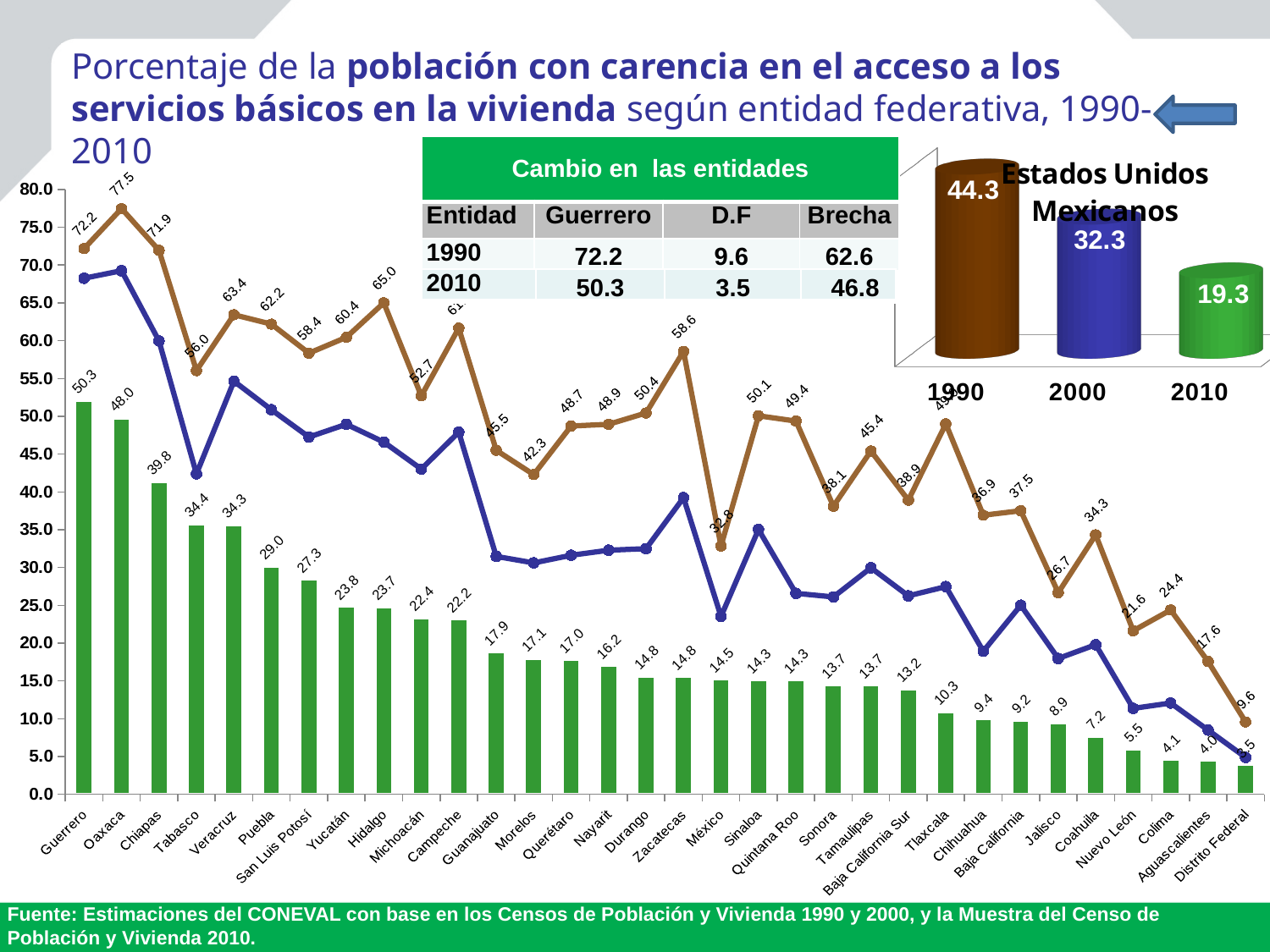
In the main chart, what is the 2010 bar value for Guerrero? 50.3 In the 'Estados Unidos Mexicanos' chart, do the values rise or fall from 1990 to 2010? fall In the main chart, what is the 2010 bar value for Distrito Federal? 3.5 In the main chart, is the 2000 line value for Guerrero greater or less than 65.0? greater How many entities are shown on the x axis of the main chart? 32 In the main chart, which entity has the lowest 2010 bar value? Distrito Federal In the main chart, what is the difference between the 2010 bar values of Guerrero and Oaxaca? 2.3 What kind of chart is the 'Estados Unidos Mexicanos' chart? bar chart In the main chart, what is the 1990 line value for Oaxaca? 77.5 In the main chart, which entity has the highest 1990 line value? Oaxaca In the main chart, which has a larger 2010 bar value, Chiapas or Tabasco? Chiapas In the 'Estados Unidos Mexicanos' chart, what is the value for 2000? 32.3